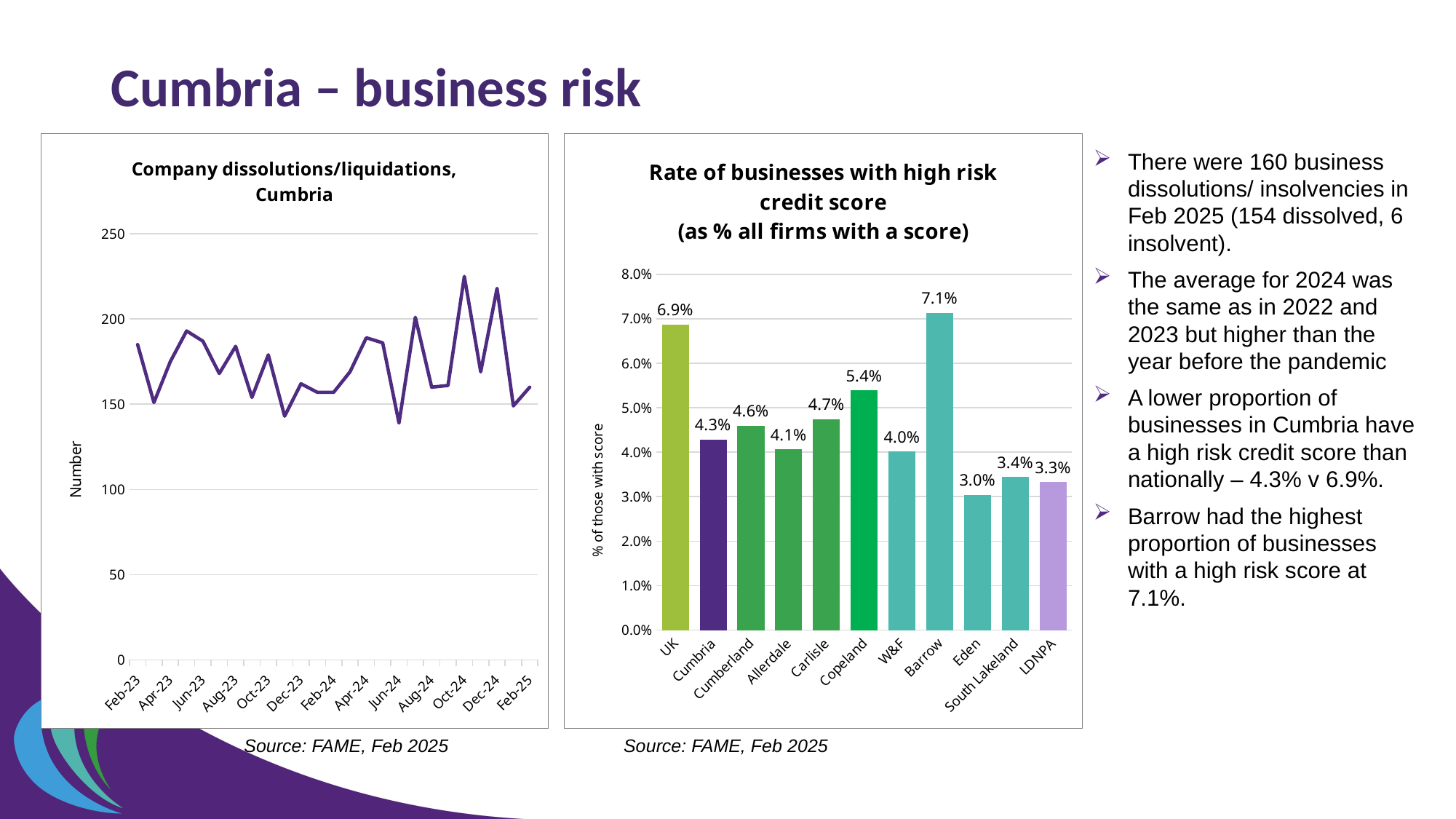
On the 'Rate of businesses with high risk credit score' chart, what is the value for the UK? 6.9% On the 'Company dissolutions/liquidations, Cumbria' chart, is the value at the Oct-24 peak greater or less than 200? greater How many areas are shown on the 'Rate of businesses with high risk credit score' chart? 11 What kind of chart is the 'Company dissolutions/liquidations, Cumbria' chart? Line chart On the 'Rate of businesses with high risk credit score' chart, which area has the highest value? Barrow What is the y-axis label on the 'Company dissolutions/liquidations, Cumbria' chart? Number On the 'Rate of businesses with high risk credit score' chart, what is the value for Cumbria? 4.3% On the 'Rate of businesses with high risk credit score' chart, which area has the lowest value? Eden On the 'Rate of businesses with high risk credit score' chart, which is larger, Copeland or Carlisle? Copeland On the 'Rate of businesses with high risk credit score' chart, what is the difference between the UK value and the Cumbria value? 2.6% On the 'Rate of businesses with high risk credit score' chart, what is the value for Copeland? 5.4% What kind of chart is the 'Rate of businesses with high risk credit score' chart? Bar chart